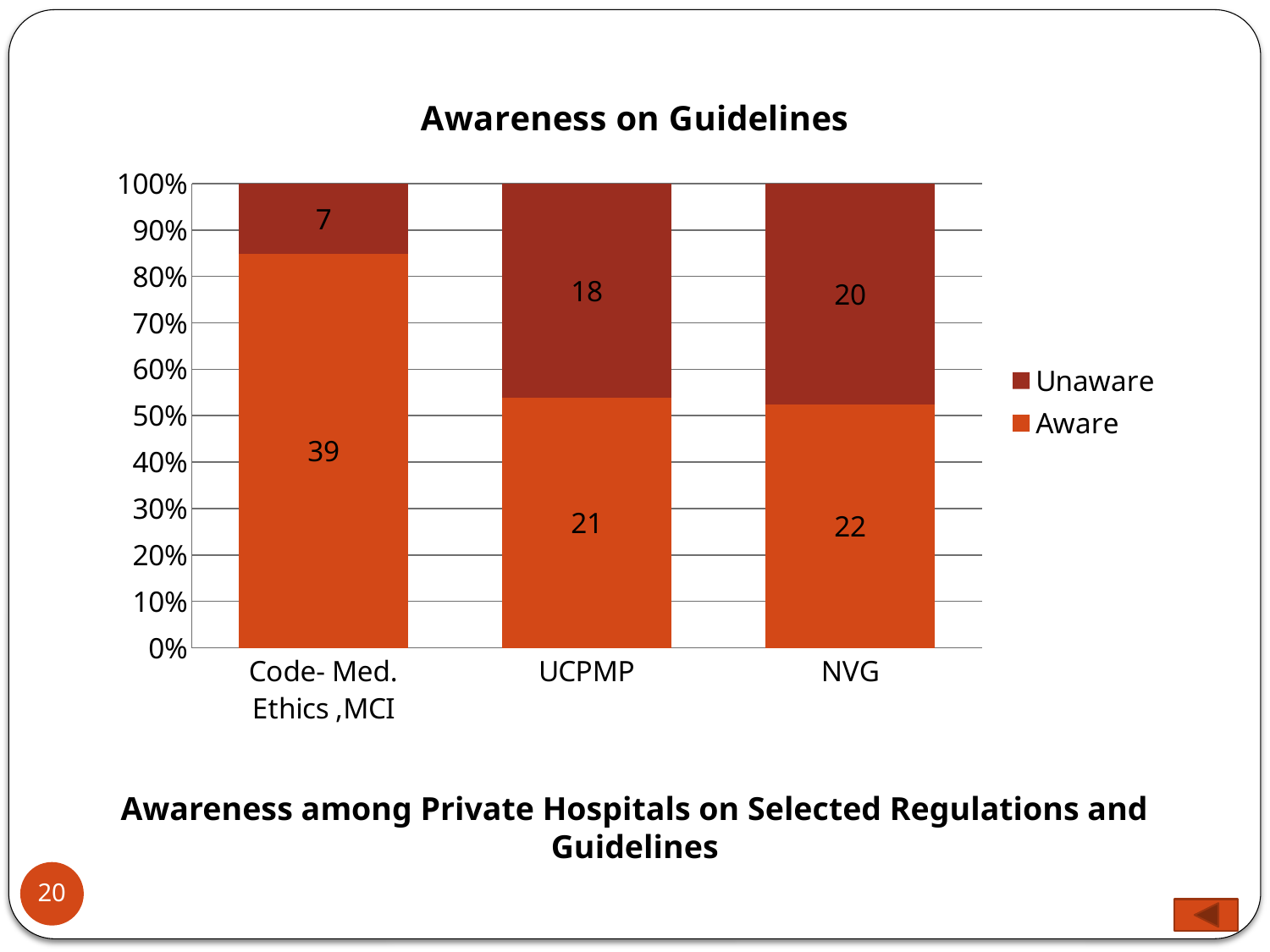
What kind of chart is shown? Stacked bar chart How many series does the legend list? 2 What is the difference between the Aware and Unaware values for Code- Med. Ethics ,MCI? 32 Which category has the lowest Unaware value? Code- Med. Ethics ,MCI What is the title of the chart? Awareness on Guidelines What is the Unaware value for Code- Med. Ethics ,MCI? 7 How many categories are shown on the x axis? 3 What is the Unaware value for NVG? 20 What is the Aware value for UCPMP? 21 What is the total of the Aware and Unaware values for UCPMP? 39 Which category has the highest Aware value? Code- Med. Ethics ,MCI Which is larger, the Aware value for NVG or the Aware value for UCPMP? NVG